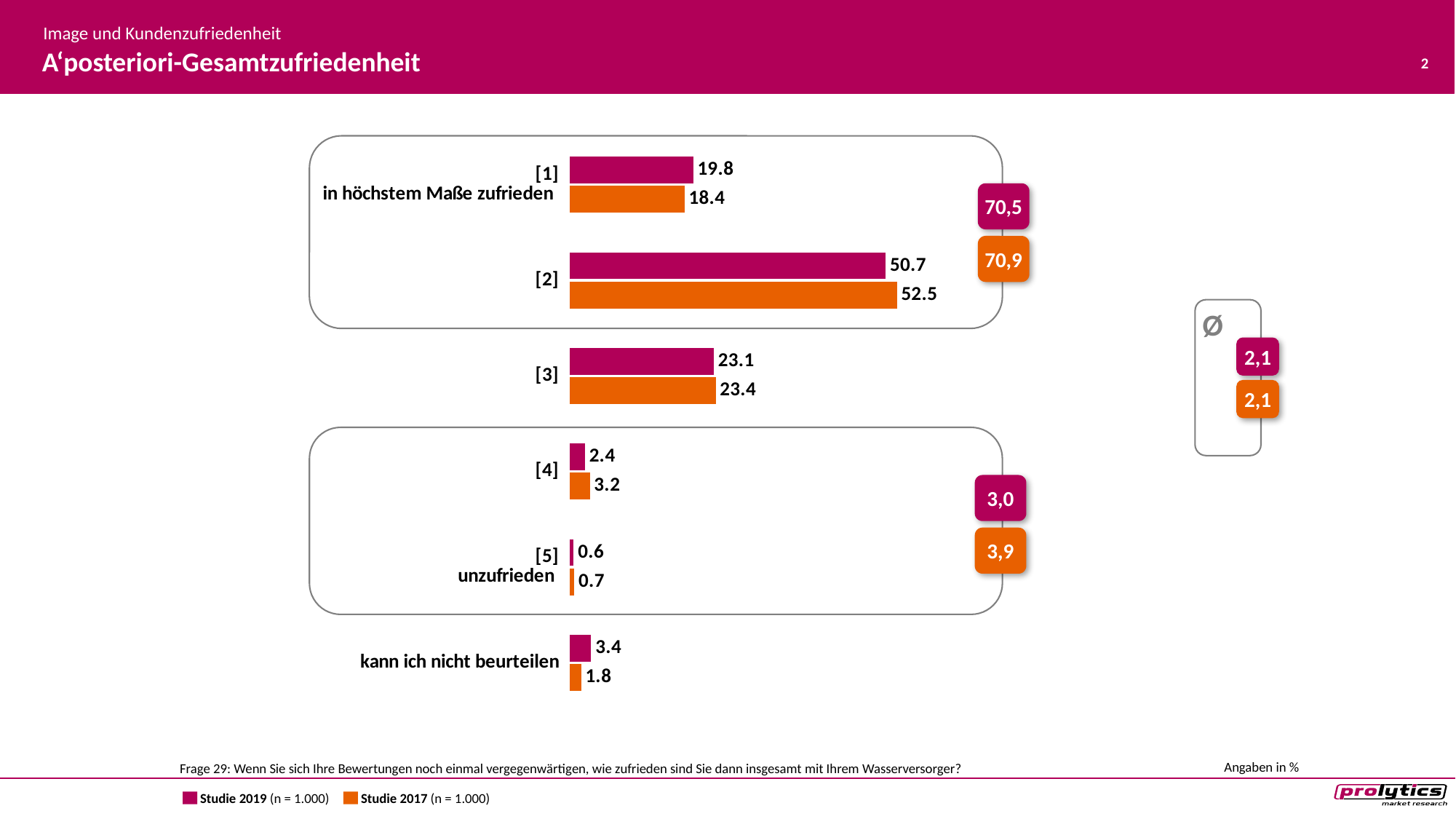
What is the value for 'kann ich nicht beurteilen' in Studie 2019? 3.4 How many series does the legend list? 2 What is the value for category [1] 'in höchstem Maße zufrieden' in Studie 2017? 18.4 What is the difference between the Studie 2017 and Studie 2019 values for category [2]? 1.8 What kind of chart is shown on the slide? bar chart Which is larger for category [4]: the Studie 2019 value or the Studie 2017 value? Studie 2017 What is the combined value of categories [1] and [2] for Studie 2019, as shown in the box on the slide? 70,5 What colour represents Studie 2017 in the chart? orange How many categories are shown in the chart? 6 Which category has the highest value in Studie 2017? [2] Which category has the lowest value in Studie 2019? [5] unzufrieden What is the value for category [2] in Studie 2019? 50.7